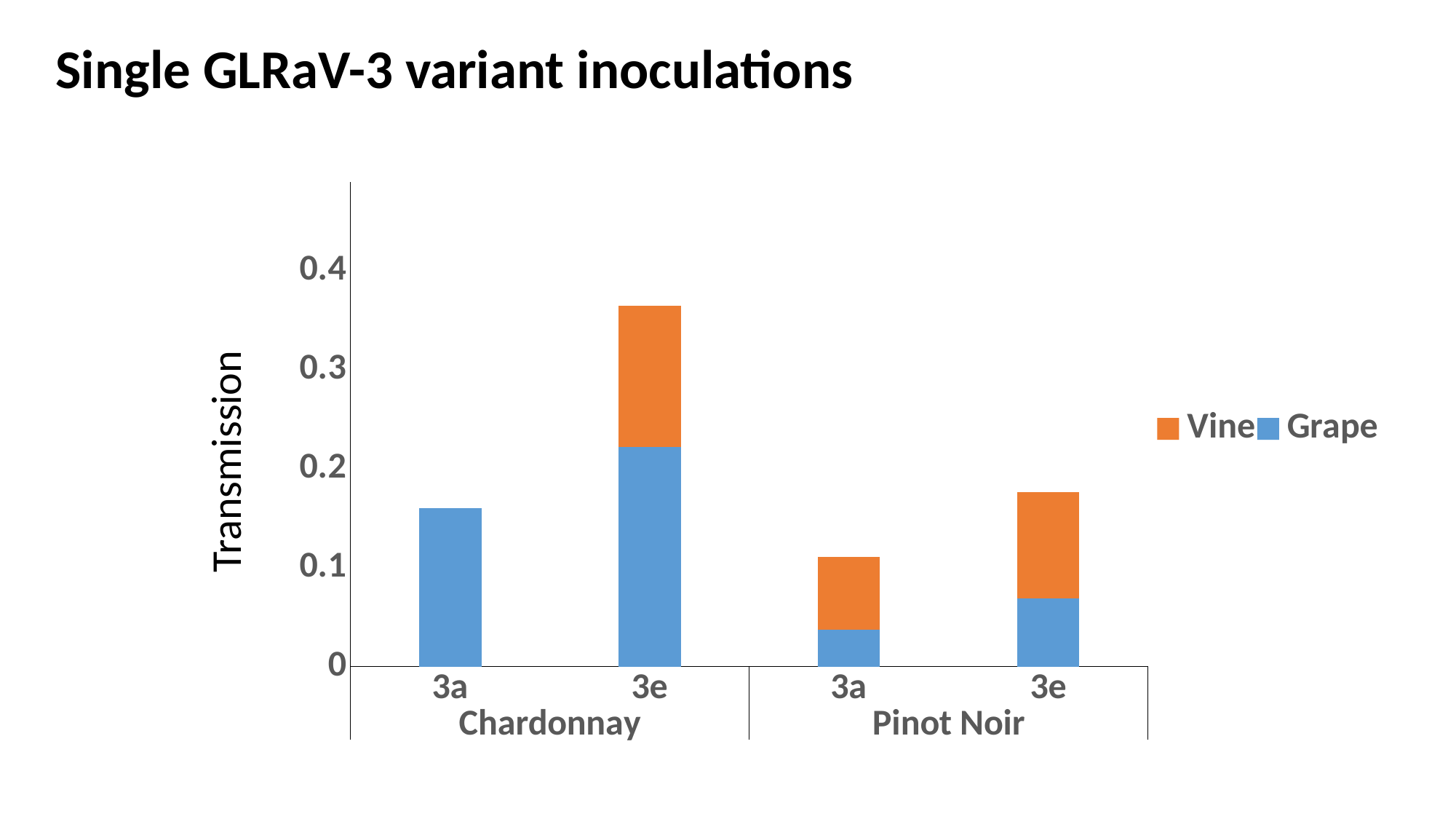
What kind of chart is shown on the slide? Stacked bar chart How many bars are plotted in the chart? 4 Which series is shown in orange in the legend? Vine Is the total transmission for Pinot Noir 3e greater or less than 0.2? less Which bar has the lowest total transmission? Pinot Noir 3a What is the label on the vertical axis? Transmission How many series does the legend list? 2 Which bar has the highest total transmission? Chardonnay 3e Is the total transmission for Pinot Noir 3a greater or less than 0.2? less Is the total transmission for Chardonnay 3a greater or less than 0.2? less Which has the larger total transmission, Chardonnay 3e or Pinot Noir 3e? Chardonnay 3e